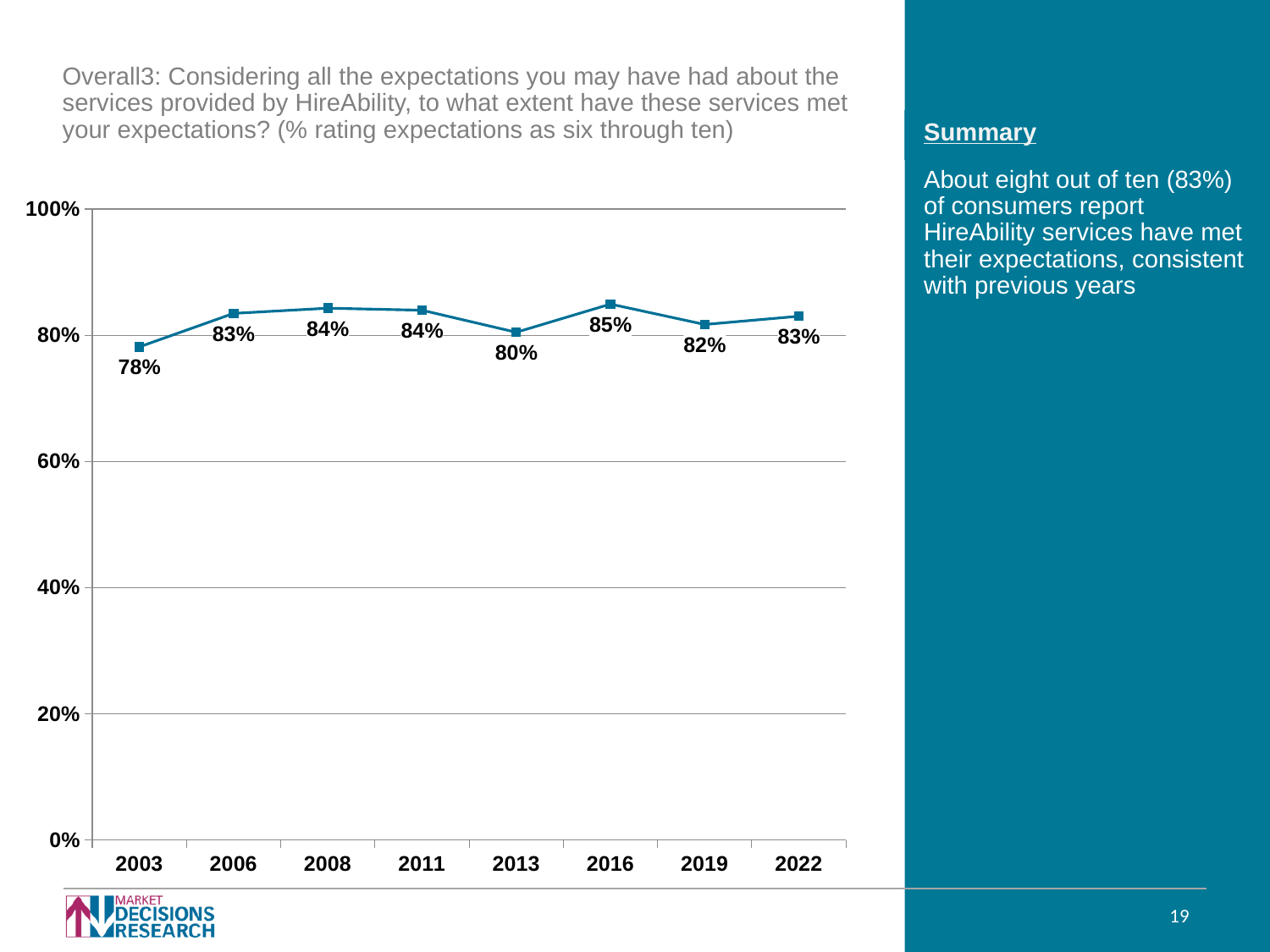
How many years are plotted on the chart? 8 Did the value rise or fall from 2003 to 2006? Rise What is the value shown for 2013? 80% What kind of chart is shown on the slide? Line chart What percentage of consumers rated expectations as met in 2003? 78% Is the value for 2013 greater or less than 60%? greater Which year has a higher value, 2019 or 2022? 2022 What is the difference between the 2016 value and the 2003 value? 7 percentage points Which year has the highest value on the chart? 2016 What is the value shown for 2022? 83% What is the maximum value shown on the vertical axis? 100% Which year has the lowest value on the chart? 2003